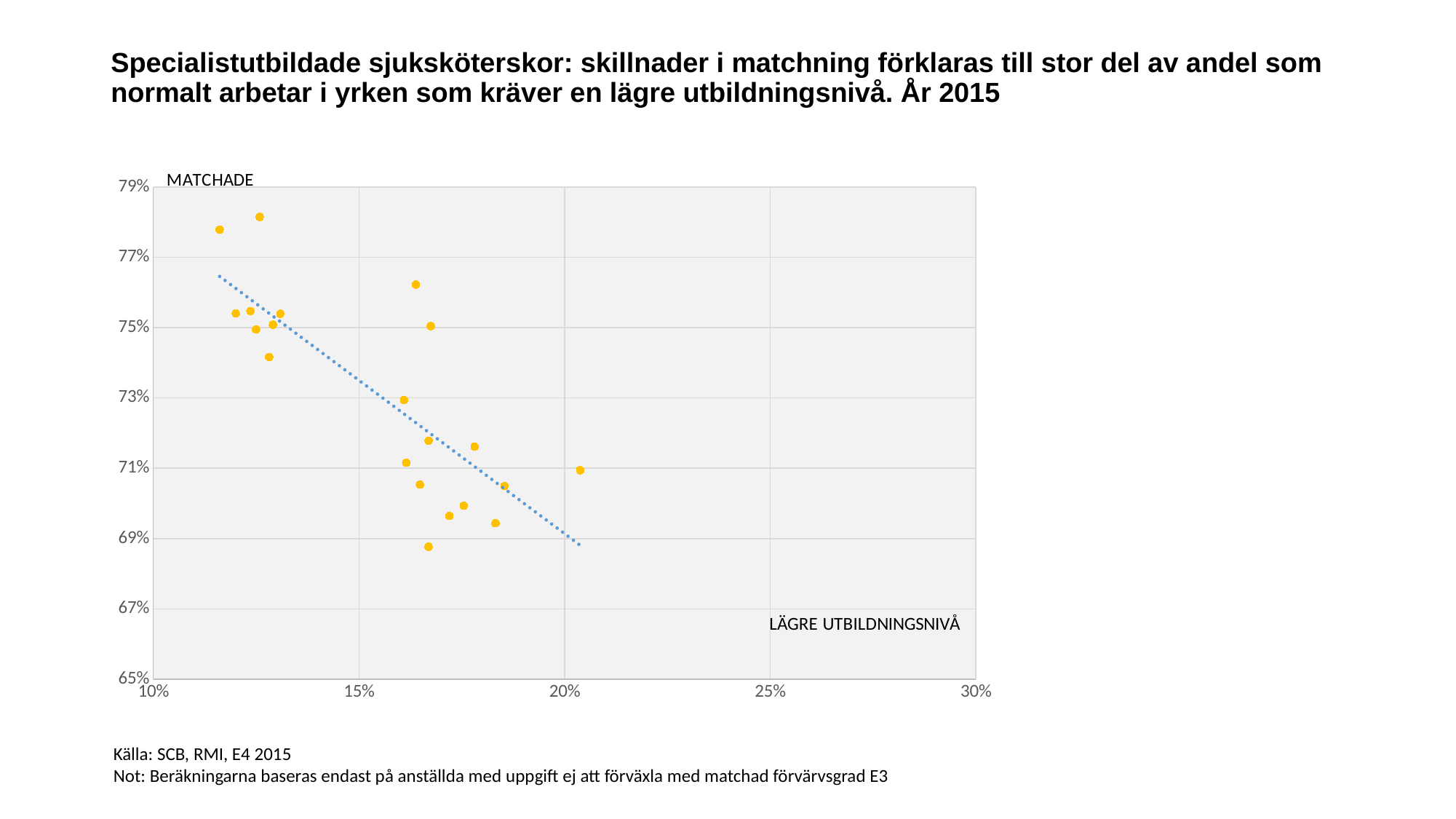
Is the lowest plotted MATCHADE value greater or less than 69%? less Which year does the chart title refer to? 2015 Is the largest LÄGRE UTBILDNINGSNIVÅ value among the plotted points greater or less than 20%? greater What is the label of the vertical axis of the chart? MATCHADE What is the maximum value shown on the horizontal axis? 30% How many data points are plotted in the chart? 21 How many plotted points have a MATCHADE value above 77%? 2 Is the highest plotted MATCHADE value greater or less than 77%? greater What kind of chart is shown on the slide? scatter plot How many plotted points have a LÄGRE UTBILDNINGSNIVÅ value above 20%? 1 Do the plotted values tend to rise or fall as the x-axis value (LÄGRE UTBILDNINGSNIVÅ) increases? fall